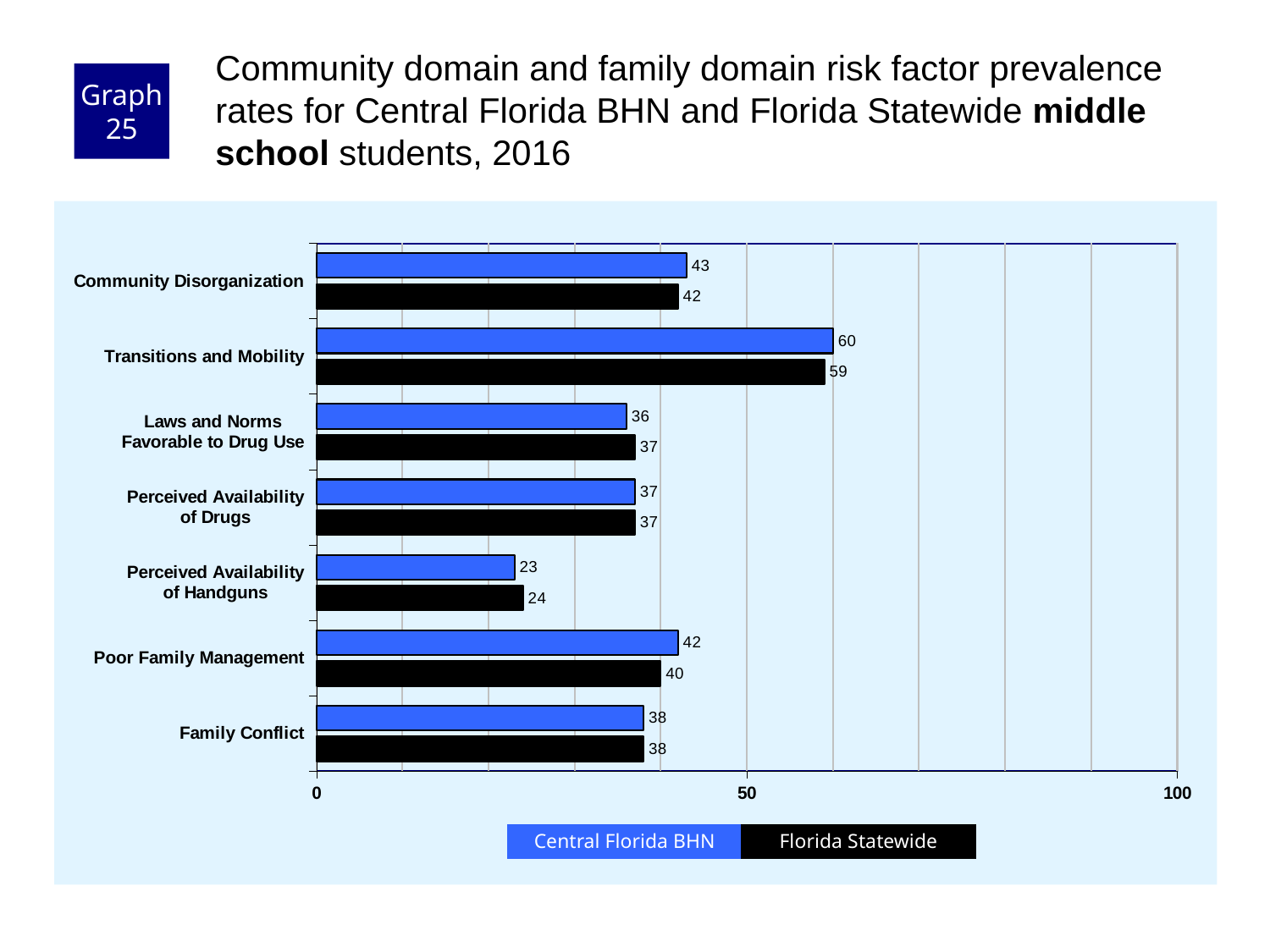
How many risk factors are shown on the chart? 7 What is the Florida Statewide value for Poor Family Management? 40 What is the Florida Statewide value for Perceived Availability of Handguns? 24 Which risk factor has the lowest Florida Statewide value? Perceived Availability of Handguns What kind of chart is shown on the slide? Bar chart Which is larger for Transitions and Mobility: the Central Florida BHN value or the Florida Statewide value? Central Florida BHN Is the Central Florida BHN value for Transitions and Mobility greater or less than 50? greater Which risk factor has the highest Central Florida BHN value? Transitions and Mobility Which colour represents Florida Statewide in the chart? Black How many series does the legend list? 2 What is the Central Florida BHN value for Transitions and Mobility? 60 What is the difference between the Central Florida BHN and Florida Statewide values for Poor Family Management? 2